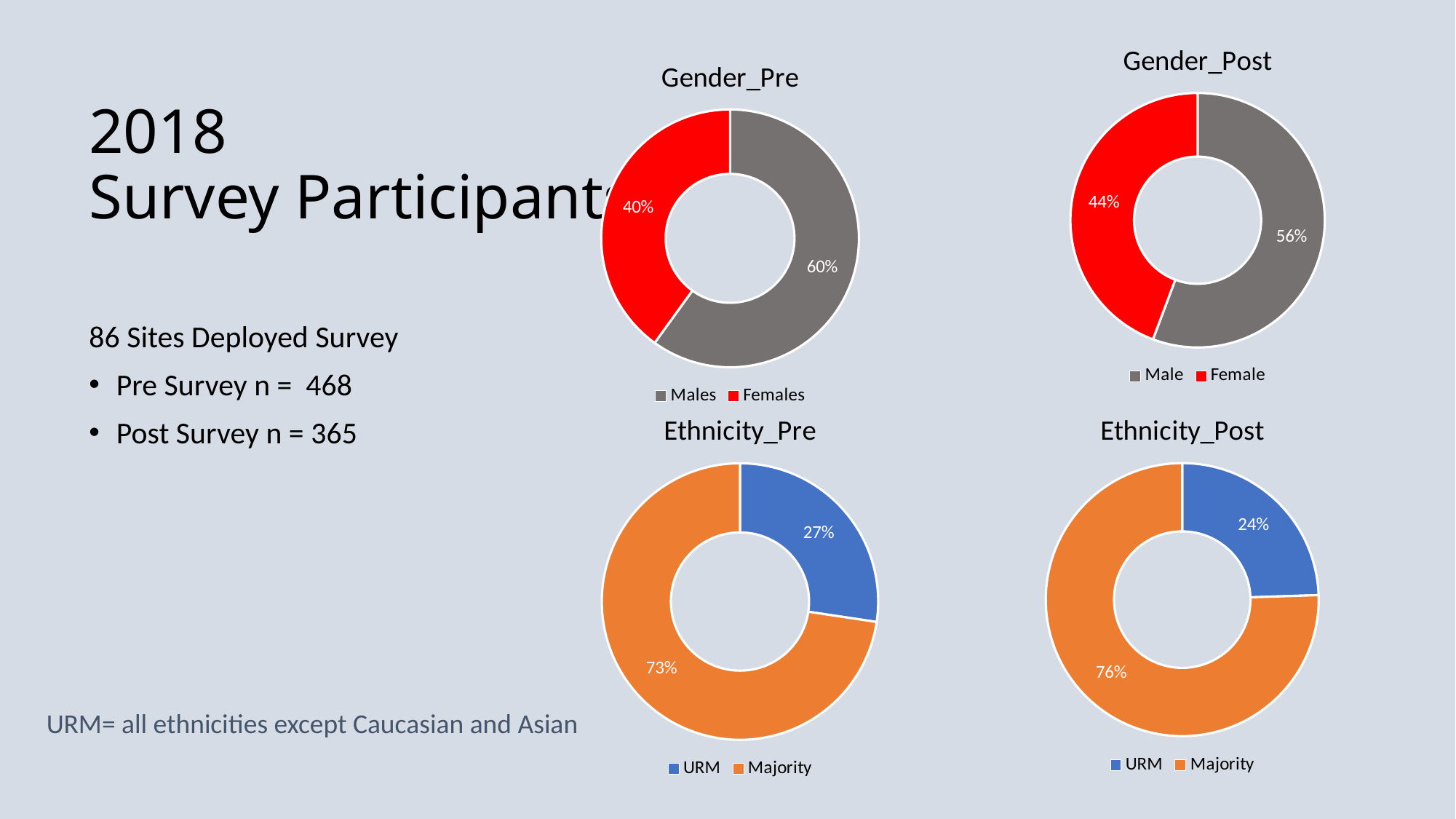
What type of chart is the Ethnicity_Pre chart? Doughnut chart In the Gender_Pre chart, which category has the largest share? Males In the Ethnicity_Pre chart, is the share for Majority larger or smaller than the share for URM? larger How many entries does the legend of the Gender_Post chart list? 2 In the Gender_Post chart, what percentage is shown for Male? 56% In the Gender_Pre chart, what percentage is shown for Females? 40% In the Gender_Post chart, what is the difference in percentage points between Male and Female? 12 In the Gender_Pre chart, what percentage is shown for Males? 60% In the Gender_Post chart, what percentage is shown for Female? 44% In the Ethnicity_Post chart, what percentage is shown for Majority? 76% In the Ethnicity_Pre chart, what percentage is shown for URM? 27% In the Ethnicity_Post chart, which category has the smallest share? URM